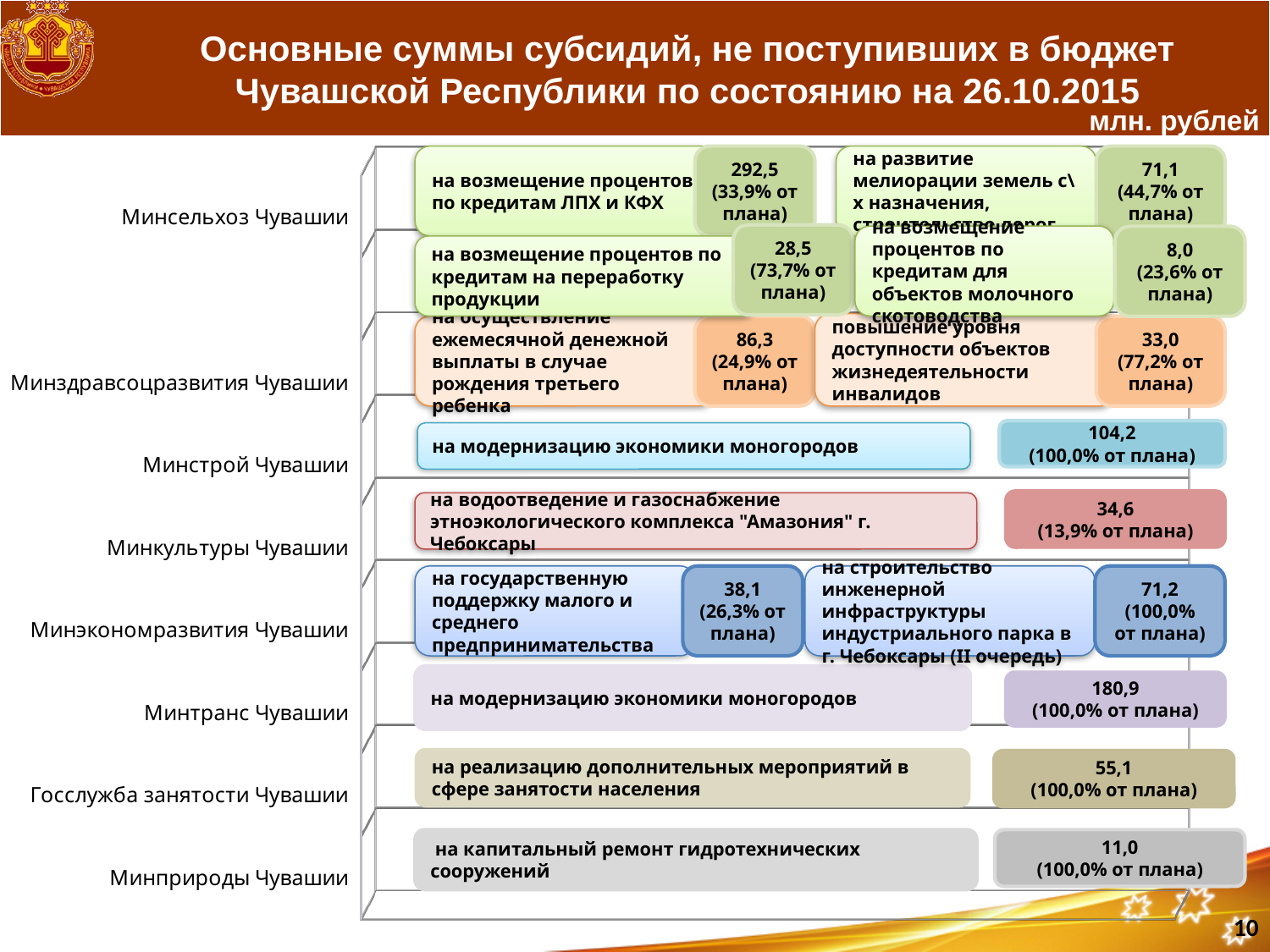
Which is larger: the subsidy for additional employment measures (Госслужба занятости Чувашии) or the subsidy for capital repair of hydraulic structures (Минприроды Чувашии)? Госслужба занятости Чувашии (55,1) Which single subsidy amount shown on the slide is the largest? 292,5 (на возмещение процентов по кредитам ЛПХ и КФХ, Минсельхоз Чувашии) What unit of measurement is indicated for the values on the slide? млн. рублей What is the amount of the subsidy for capital repair of hydraulic structures for Минприроды Чувашии? 11,0 What kind of chart is used on the slide? Bar chart What percentage of the plan does the subsidy for water disposal and gas supply of the 'Амазония' complex (Минкультуры Чувашии) represent? 13,9% от плана What is the amount of the subsidy for modernisation of the economy of monotowns for Минстрой Чувашии? 104,2 What is the difference between the monotown modernisation subsidy for Минтранс Чувашии (180,9) and for Минстрой Чувашии (104,2)? 76,7 What is the amount of the subsidy for modernisation of the economy of monotowns (на модернизацию экономики моногородов) for Минтранс Чувашии? 180,9 What is the amount of the subsidy for reimbursement of interest on loans to ЛПХ and КФХ (Минсельхоз Чувашии)? 292,5 What is the amount of the subsidy for state support of small and medium business (Минэкономразвития Чувашии)? 38,1 How many ministries/agencies are listed as categories on the chart? 8